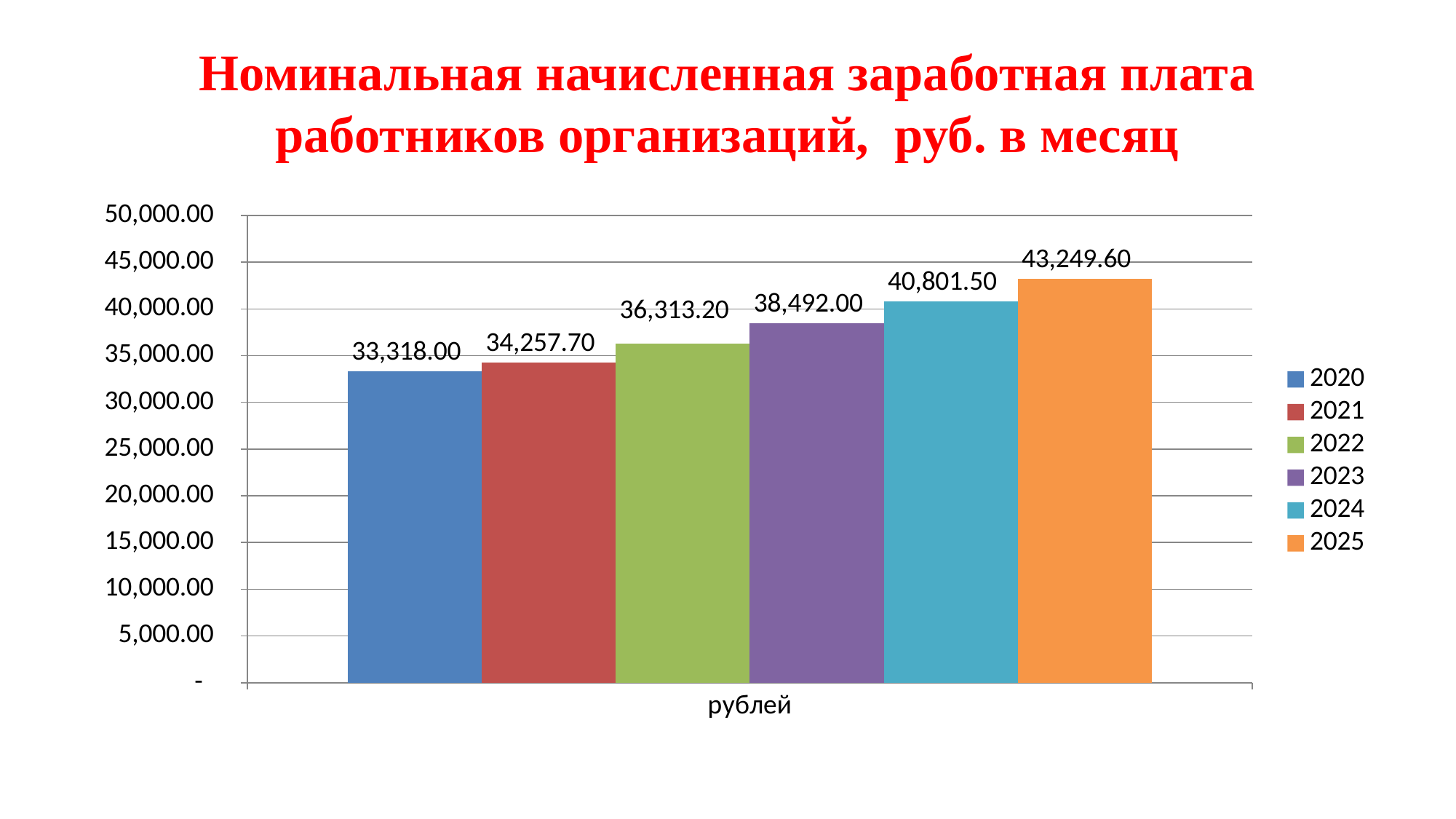
What is the difference between the values for 2025 and 2020? 9,931.60 What is the value for 2020? 33,318.00 What is the value for 2023? 38,492.00 What is the value for 2025? 43,249.60 Which is larger, the value for 2021 or the value for 2022? 2022 Which year has the highest value? 2025 Do the values rise or fall from 2020 to 2025? rise Is the value for 2024 greater or less than 40,000.00? greater Which year has the lowest value? 2020 How many series does the legend list? 6 What kind of chart is shown on the slide? bar chart What is the difference between the values for 2024 and 2023? 2,309.50